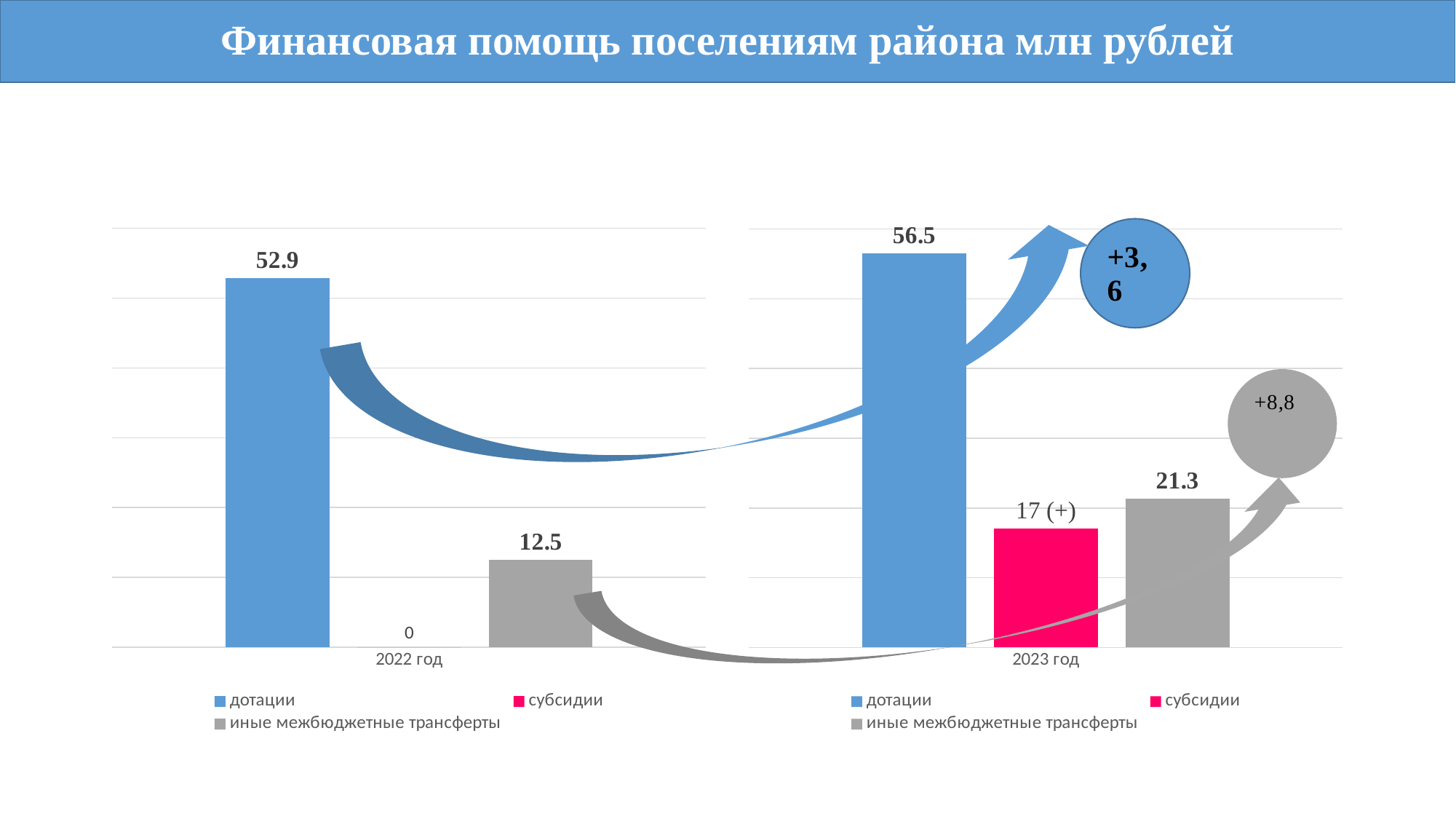
In the 2022 год chart, what is the value for иные межбюджетные трансферты? 12.5 What is the difference between иные межбюджетные трансферты in the 2023 год chart and in the 2022 год chart? 8.8 How many series does the legend of the 2022 год chart list? 3 In the 2023 год chart, what is the value for дотации? 56.5 What type of chart is the 2023 год chart? bar chart In the 2023 год chart, which series has the highest value? дотации In the 2023 год chart, what is the value for иные межбюджетные трансферты? 21.3 In the 2022 год chart, what is the value for субсидии? 0 In the 2023 год chart, which is larger: субсидии or иные межбюджетные трансферты? иные межбюджетные трансферты In the 2022 год chart, what is the value for дотации? 52.9 In the 2023 год chart, which series has the lowest value? субсидии What is the difference between дотации in the 2023 год chart and дотации in the 2022 год chart? 3.6